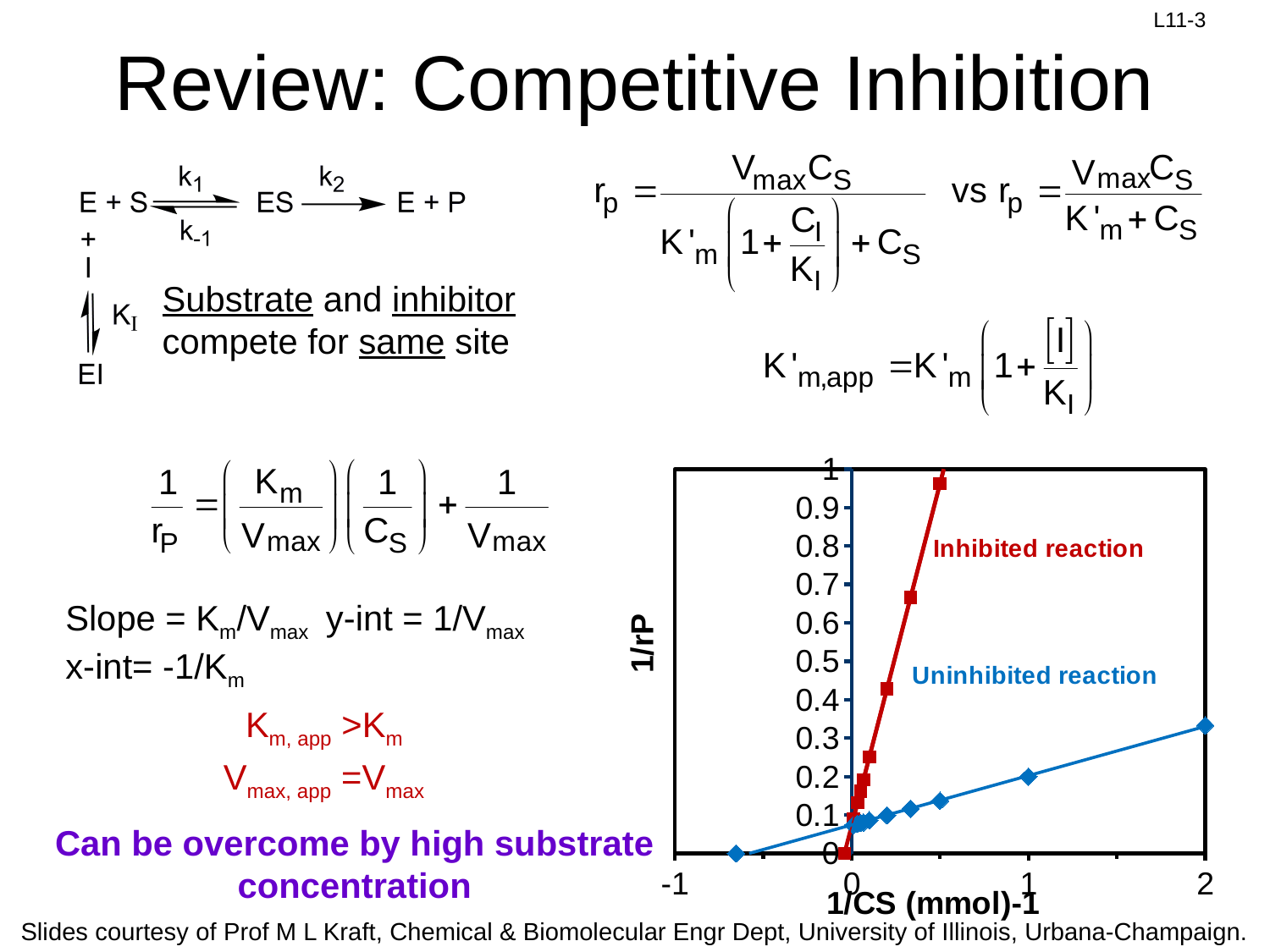
What kind of chart is shown on the slide? Line chart (scatter with lines) Is the value of the uninhibited reaction at 1/CS = 2 greater or less than 0.5? less Is the value of the uninhibited reaction at 1/CS = 1 greater or less than 0.3? less Which series has the steeper slope, the inhibited reaction or the uninhibited reaction? Inhibited reaction Does 1/rP rise or fall as 1/CS increases for the inhibited reaction? Rise Does 1/rP rise or fall as 1/CS increases for the uninhibited reaction? Rise How many series does the chart show? 2 What is the highest tick value shown on the y axis of the chart? 1 What are the two series labelled on the chart? Inhibited reaction and Uninhibited reaction What is the label of the x axis of the chart? 1/CS (mmol)-1 At 1/CS of about 0.5, which series has the larger 1/rP value? Inhibited reaction Is the highest plotted value of the inhibited reaction greater or less than 0.9? greater